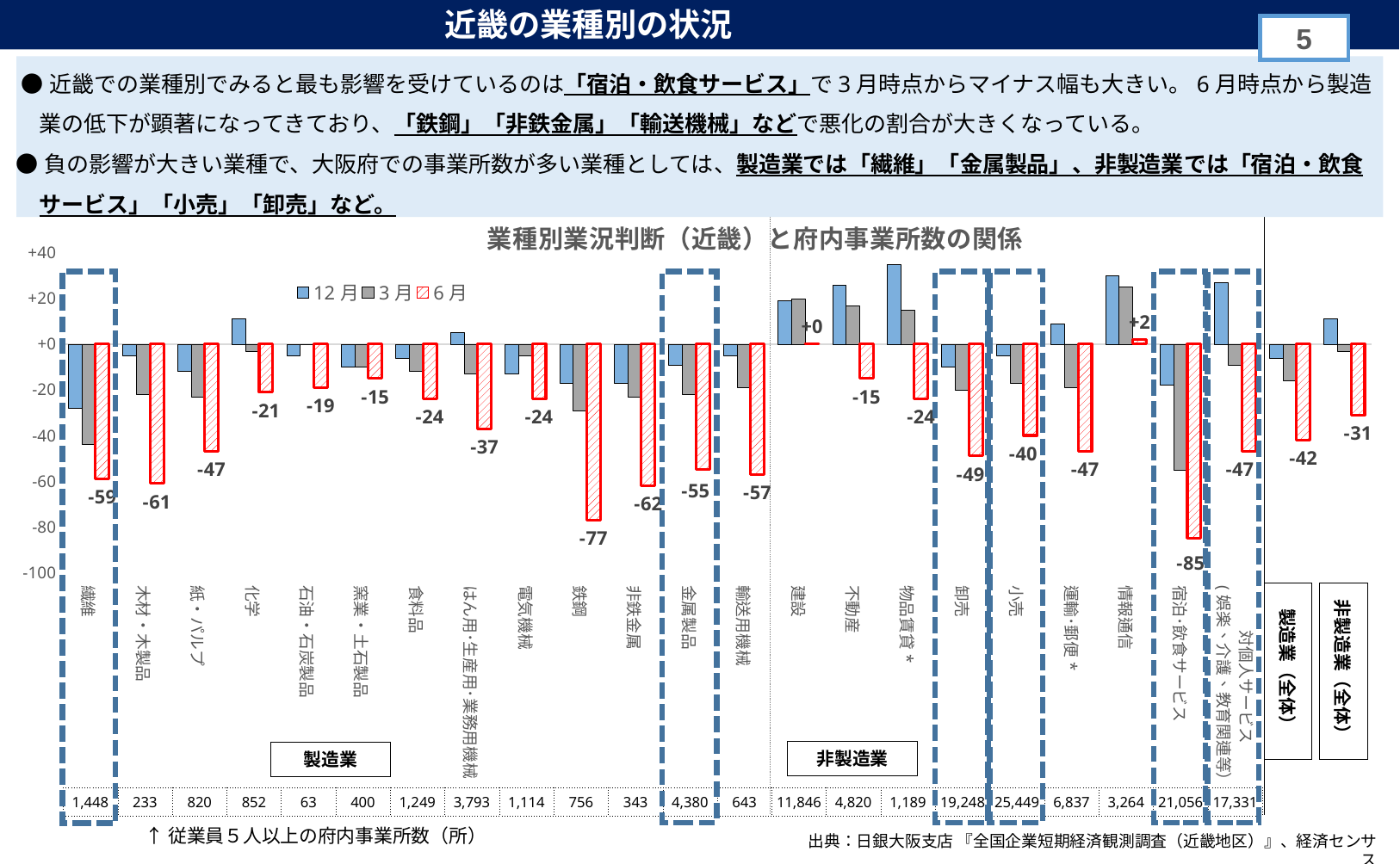
What is the title of the chart? 業種別業況判断（近畿）と府内事業所数の関係 Is the 12月 value for 物品賃貸 greater or less than +20? greater What is the 6月 value for 情報通信? +2 What is the 6月 value for 宿泊・飲食サービス? -85 Which category has the lowest 6月 value? 宿泊・飲食サービス Which category has the highest 6月 value? 情報通信 What is the number of establishments (府内事業所数) shown for 小売? 25,449 Which has a lower 6月 value, 繊維 or 木材・木製品? 木材・木製品 What kind of chart is shown? bar chart What is the difference between the 6月 values for 製造業（全体） and 非製造業（全体）? 11 How many series does the legend list? 3 What is the 6月 value for 鉄鋼? -77